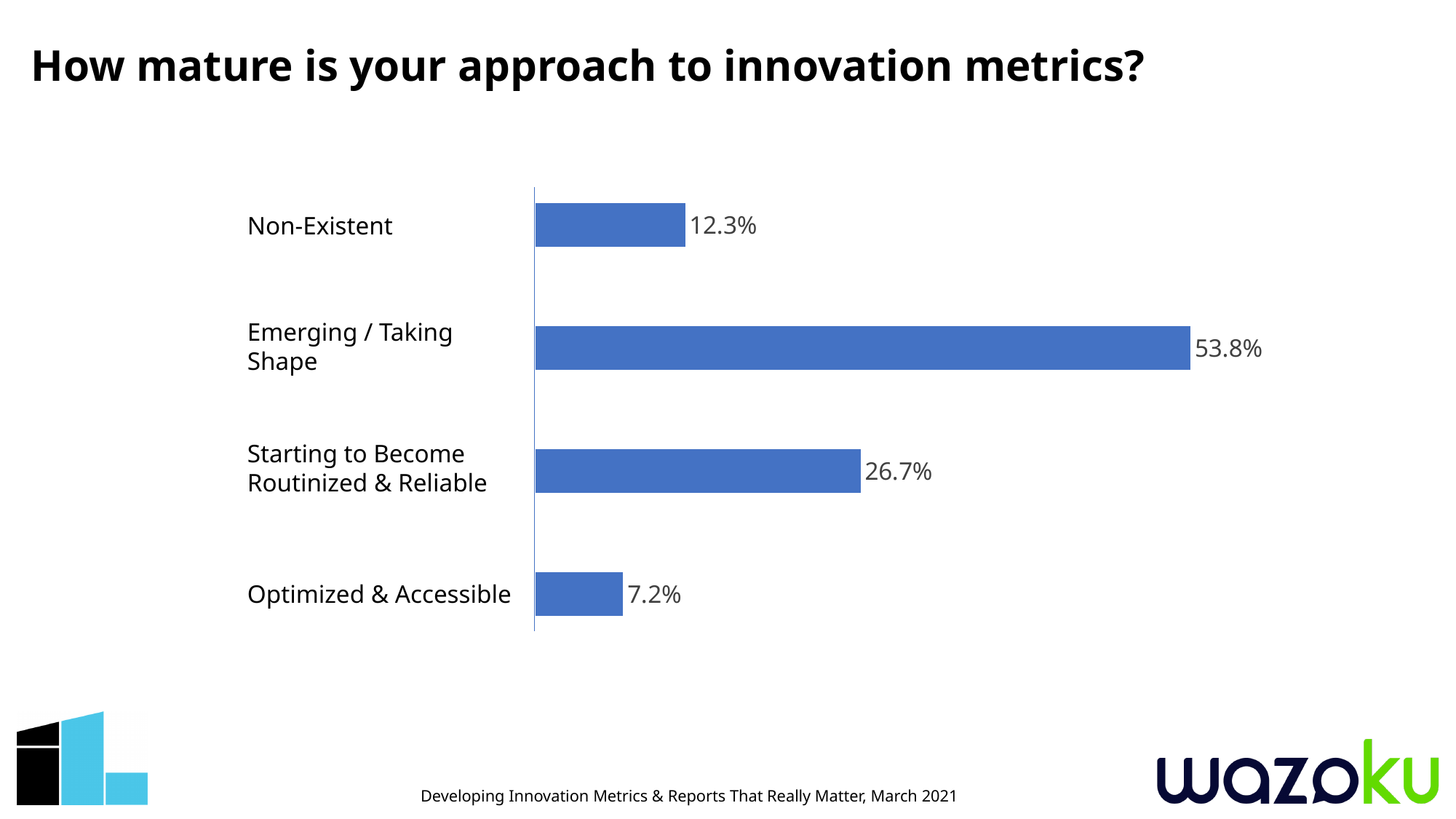
What percentage of respondents said their approach to innovation metrics is Non-Existent? 12.3% What is the value for Emerging / Taking Shape? 53.8% Which category has the lowest value? Optimized & Accessible What is the value for Optimized & Accessible? 7.2% Which is larger, the value for Non-Existent or the value for Starting to Become Routinized & Reliable? Starting to Become Routinized & Reliable What is the difference between the values for Emerging / Taking Shape and Starting to Become Routinized & Reliable? 27.1% What kind of chart is shown on the slide? Bar chart What is the difference between the values for Non-Existent and Optimized & Accessible? 5.1% What is the title of the slide containing the chart? How mature is your approach to innovation metrics? How many categories are shown in the chart? 4 What is the value for Starting to Become Routinized & Reliable? 26.7% Which category has the highest value? Emerging / Taking Shape